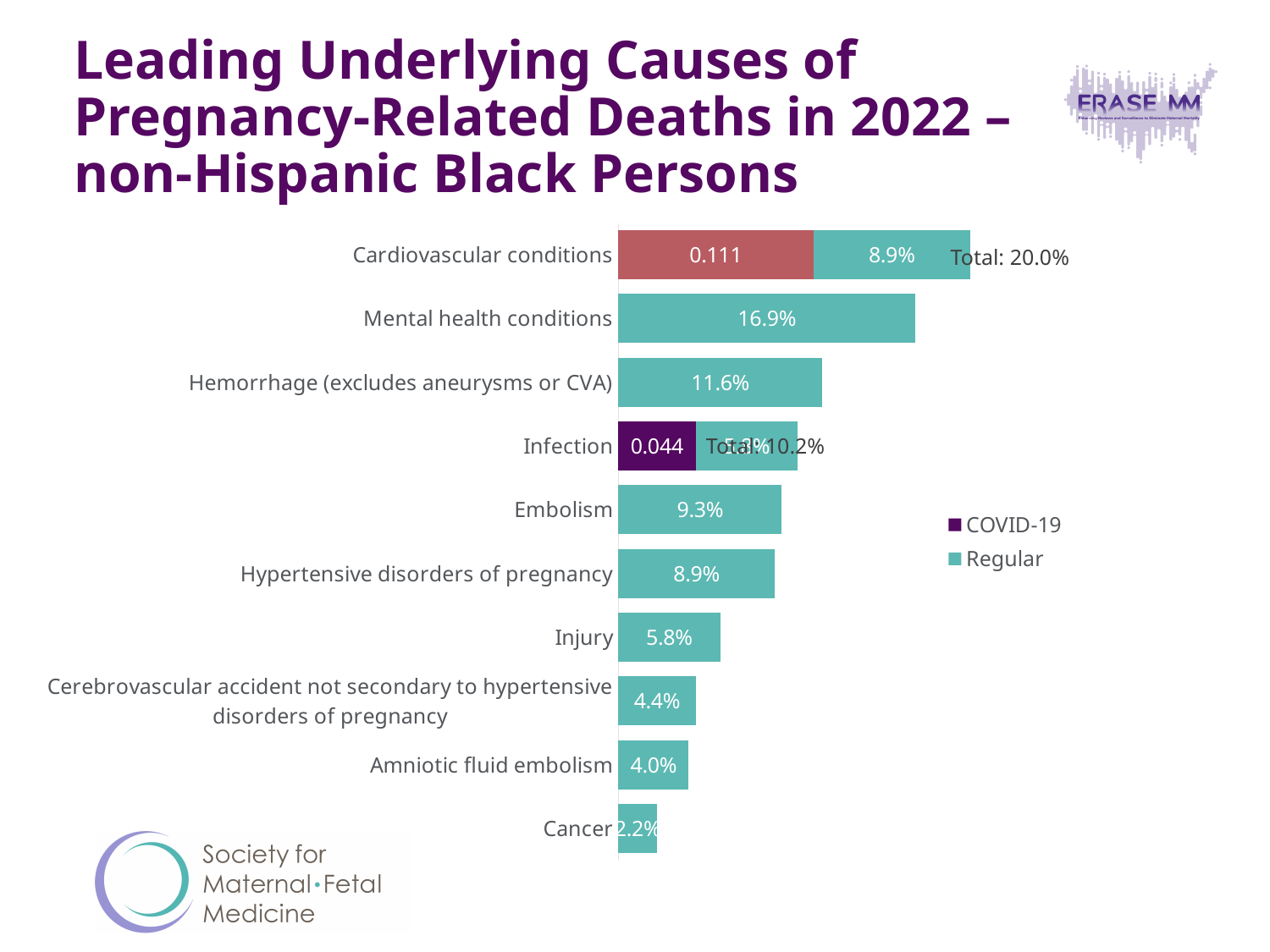
What kind of chart is shown on the slide? bar chart Which cause has the highest total on the chart? Cardiovascular conditions What is the difference between the values for Mental health conditions and Hemorrhage (excludes aneurysms or CVA)? 5.3% What is the total for the Cardiovascular conditions bar? 20.0% What is the value for Hemorrhage (excludes aneurysms or CVA)? 11.6% How many causes of death are listed on the chart? 10 What are the two series named in the legend? COVID-19 and Regular Which cause has the lowest value on the chart? Cancer What is the total for the Infection bar? 10.2% What is the value for Mental health conditions? 16.9% How many series does the legend list? 2